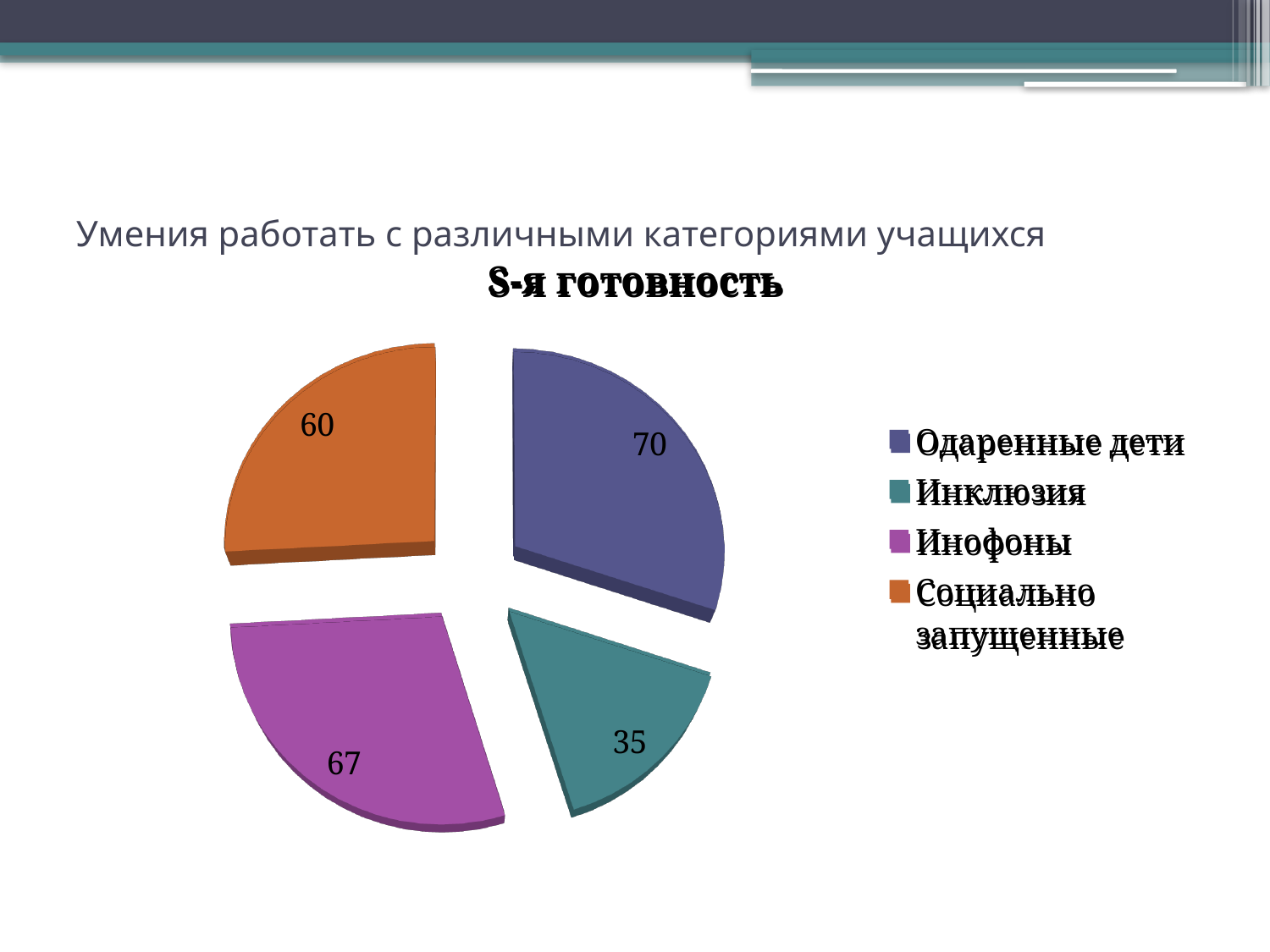
How many categories does the pie chart show? 4 Which colour represents Социально запущенные in the legend? Orange What type of chart is shown on the slide? Pie chart Which is larger, the value for Инофоны or the value for Социально запущенные? Инофоны What is the value for Инофоны? 67 What is the value for Одаренные дети? 70 What is the title of the pie chart? S-я готовность What is the value for Инклюзия? 35 Which category has the largest value? Одаренные дети What is the difference between the values for Одаренные дети and Инклюзия? 35 Which category has the smallest value? Инклюзия What is the value for Социально запущенные? 60